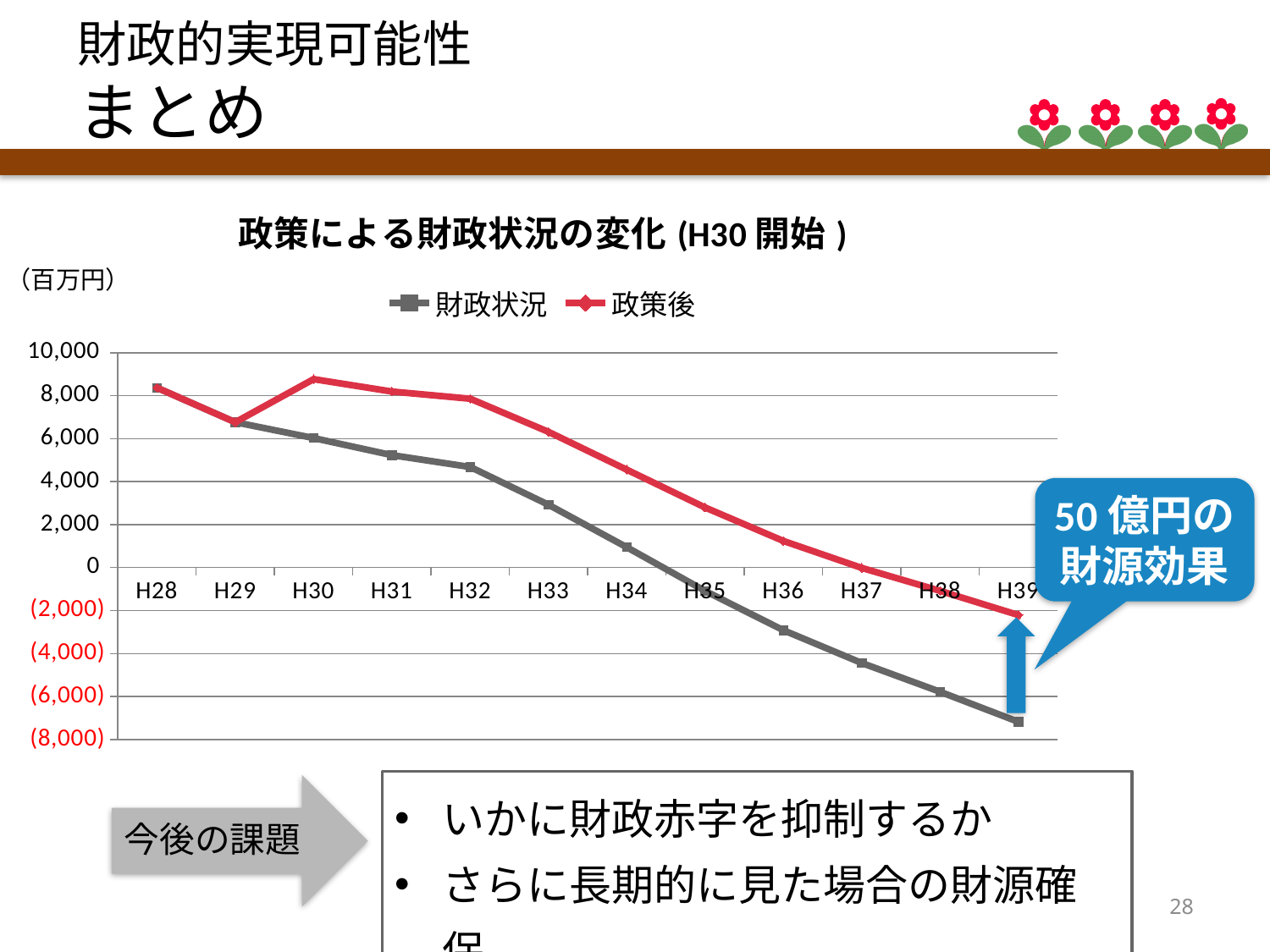
At H33, which series has the higher value, 財政状況 or 政策後? 政策後 How many series does the legend list? 2 What kind of chart is shown on the slide? line chart Is the value of 政策後 at H36 greater or less than 2,000? less Is the value of 政策後 at H30 greater or less than 8,000? greater How many years are plotted along the x axis? 12 In which year does the 財政状況 series reach its lowest value? H39 Which series is drawn in red? 政策後 Does the 財政状況 series rise or fall from H28 to H39? fall Is the value of 財政状況 at H32 greater or less than 4,000? greater What is the title of the chart? 政策による財政状況の変化 (H30 開始 ) In which year does the 政策後 series reach its highest value? H30